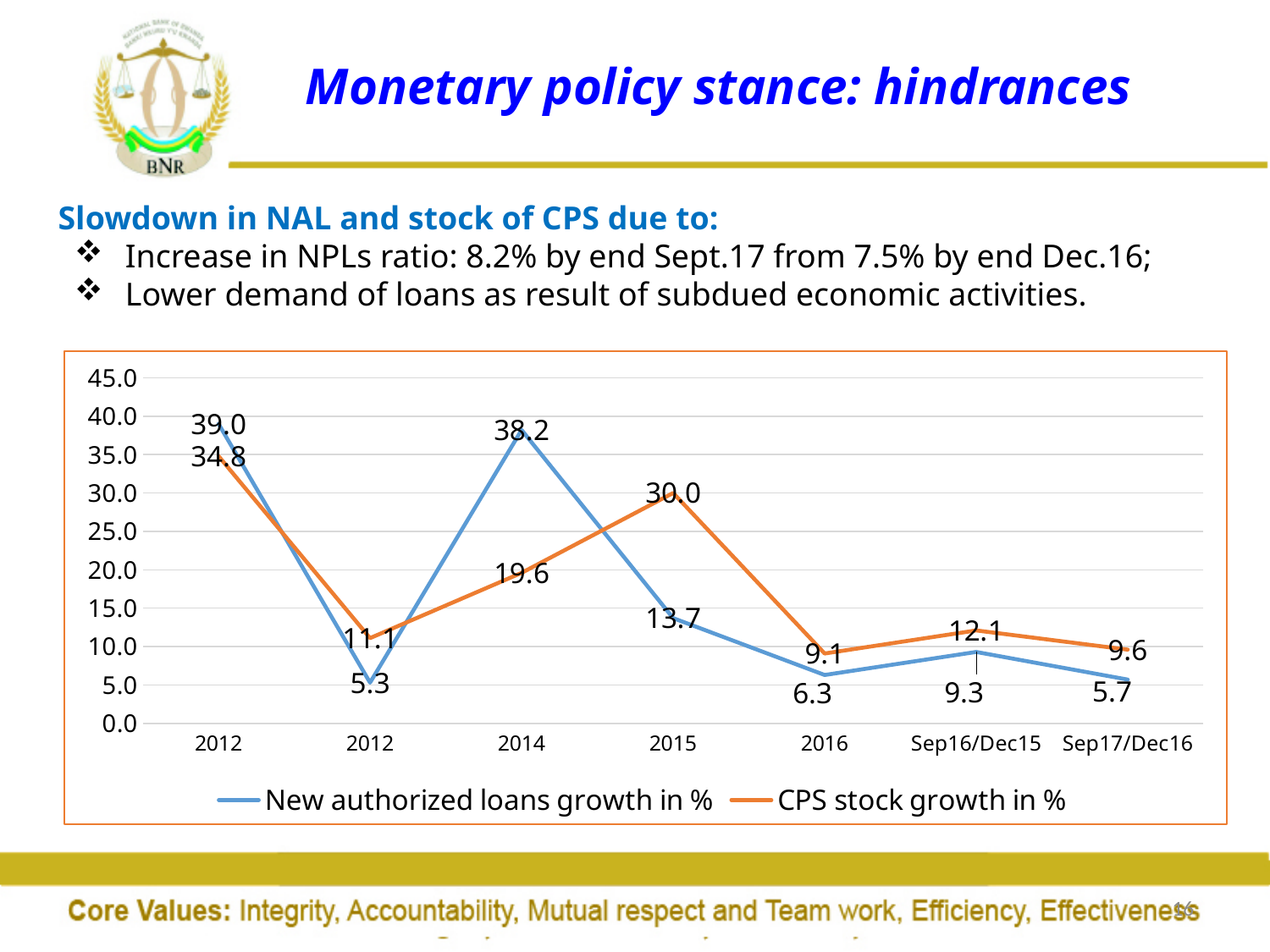
In which category is CPS stock growth in % lowest? 2016 Between 2015 and 2016, does CPS stock growth in % rise or fall? fall In 2014, which series has the higher value: New authorized loans growth in % or CPS stock growth in %? New authorized loans growth in % What kind of chart is shown on the slide? line chart What is the difference between CPS stock growth in % and New authorized loans growth in % in 2015? 16.3 What is the value of CPS stock growth in % for Sep17/Dec16? 9.6 What is the value of New authorized loans growth in % for 2014? 38.2 How many series does the chart's legend list? 2 What is the value of CPS stock growth in % for 2015? 30.0 How many categories are shown on the x axis of the chart? 7 What is the value of New authorized loans growth in % for 2016? 6.3 What is the difference between CPS stock growth in % and New authorized loans growth in % for Sep16/Dec15? 2.8